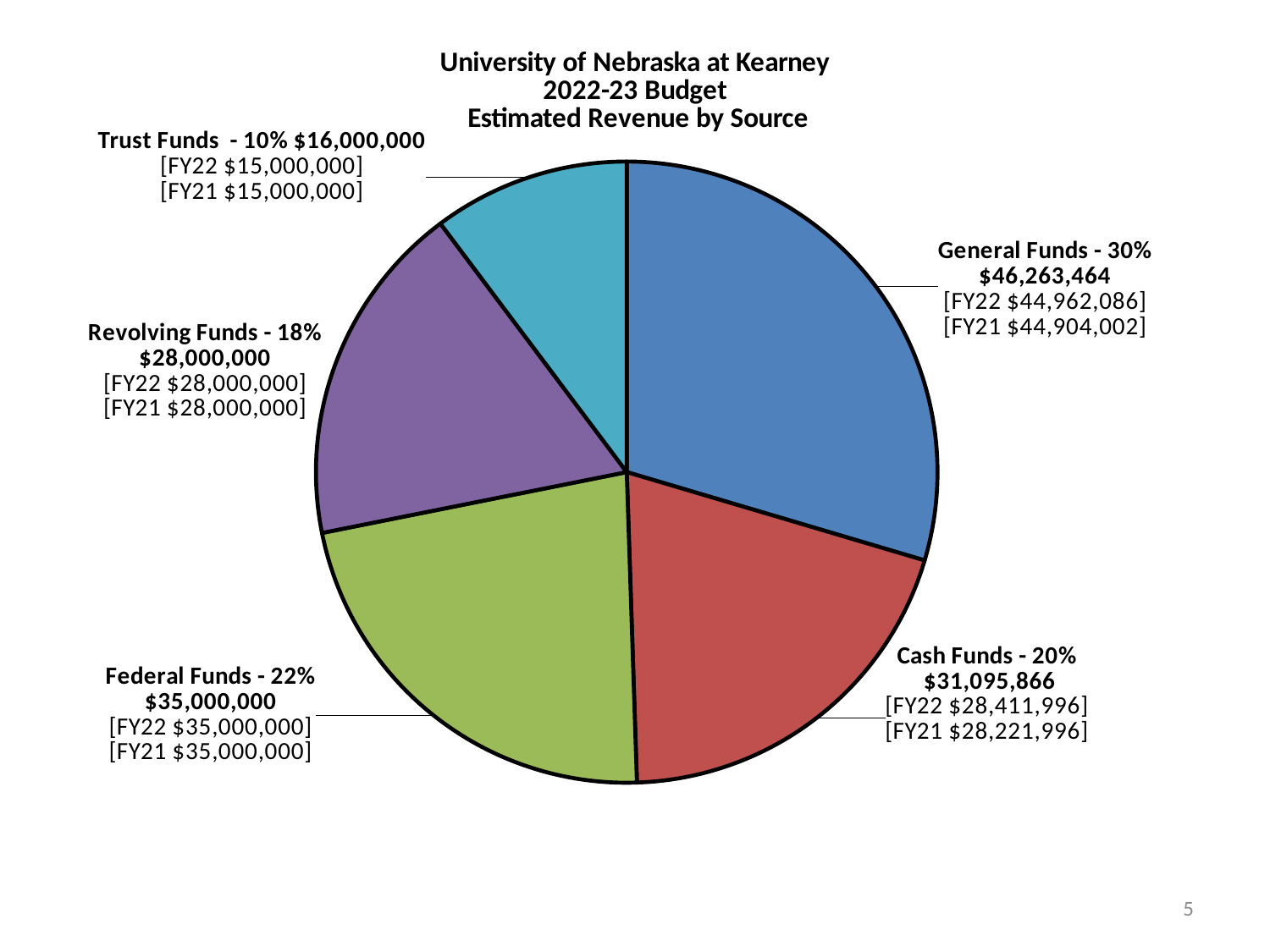
Which revenue source has the largest share of the pie? General Funds What share of the estimated revenue comes from Federal Funds? 22% What is the 2022-23 estimated revenue from Cash Funds? $31,095,866 What share of the estimated revenue comes from Trust Funds? 10% How many revenue sources (slices) does the pie chart show? 5 Which revenue source has the smallest share of the pie? Trust Funds What was the FY22 value for Cash Funds? $28,411,996 What is the title of the chart? University of Nebraska at Kearney 2022-23 Budget Estimated Revenue by Source Which is larger, the 2022-23 Cash Funds amount or the Federal Funds amount? Federal Funds What is the difference between the 2022-23 Federal Funds and Revolving Funds amounts? $7,000,000 What type of chart is shown on the slide? Pie chart What is the 2022-23 estimated revenue from General Funds? $46,263,464